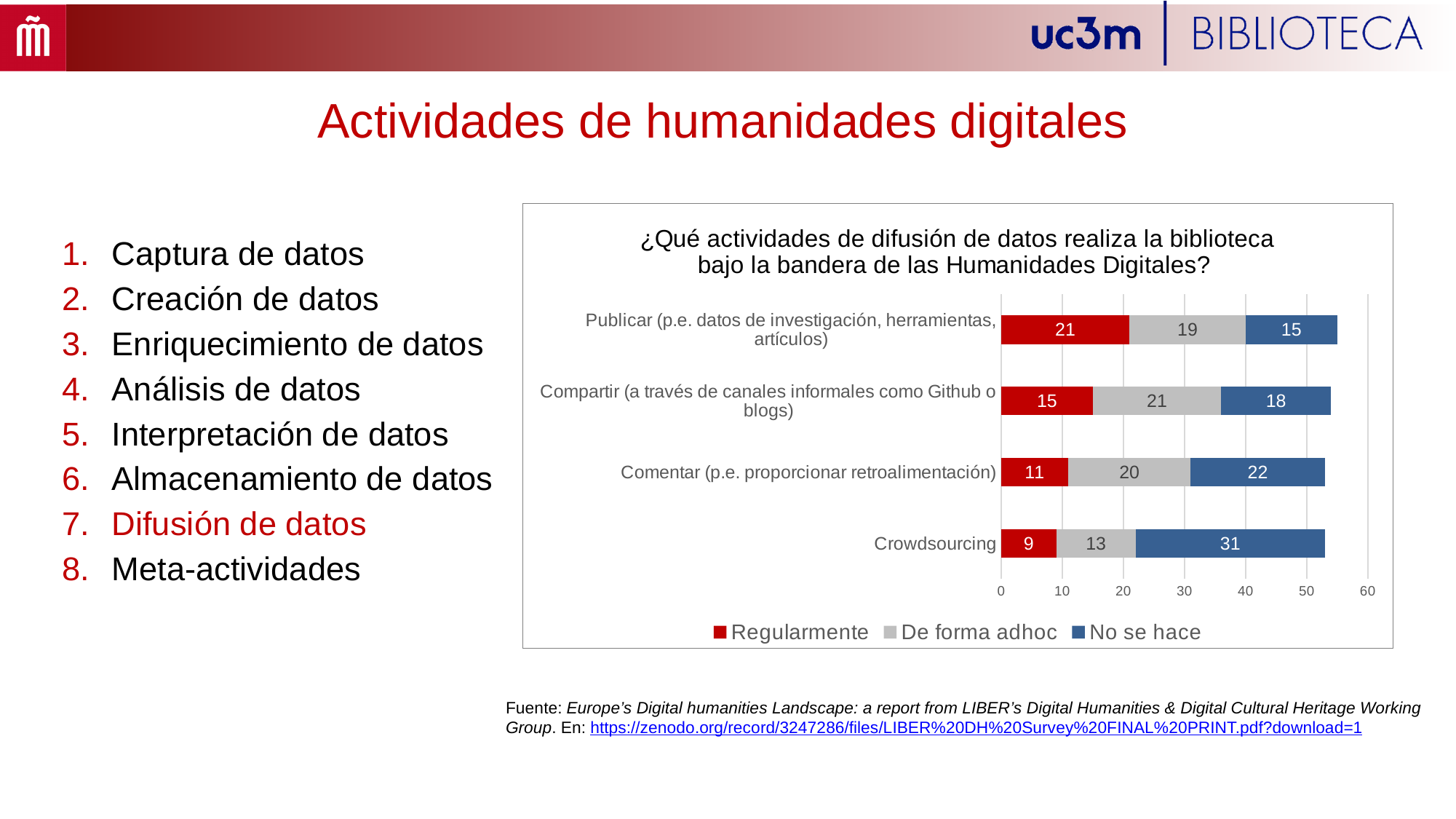
What kind of chart is shown on the slide? Stacked bar chart How many categories are shown in the chart? 4 What is the 'De forma adhoc' value for Compartir (a través de canales informales como Github o blogs)? 21 How many series does the legend list? 3 Which is larger: the 'Regularmente' value for Compartir or the 'Regularmente' value for Comentar? Compartir Which category has the lowest 'Regularmente' value? Crowdsourcing What is the total of the stacked bar for Publicar (p.e. datos de investigación, herramientas, artículos)? 55 What is the difference between the 'No se hace' values for Crowdsourcing and Comentar (p.e. proporcionar retroalimentación)? 9 What is the 'Regularmente' value for Publicar (p.e. datos de investigación, herramientas, artículos)? 21 What is the 'No se hace' value for Crowdsourcing? 31 What is the total of the stacked bar for Crowdsourcing? 53 Which category has the highest 'Regularmente' value? Publicar (p.e. datos de investigación, herramientas, artículos)